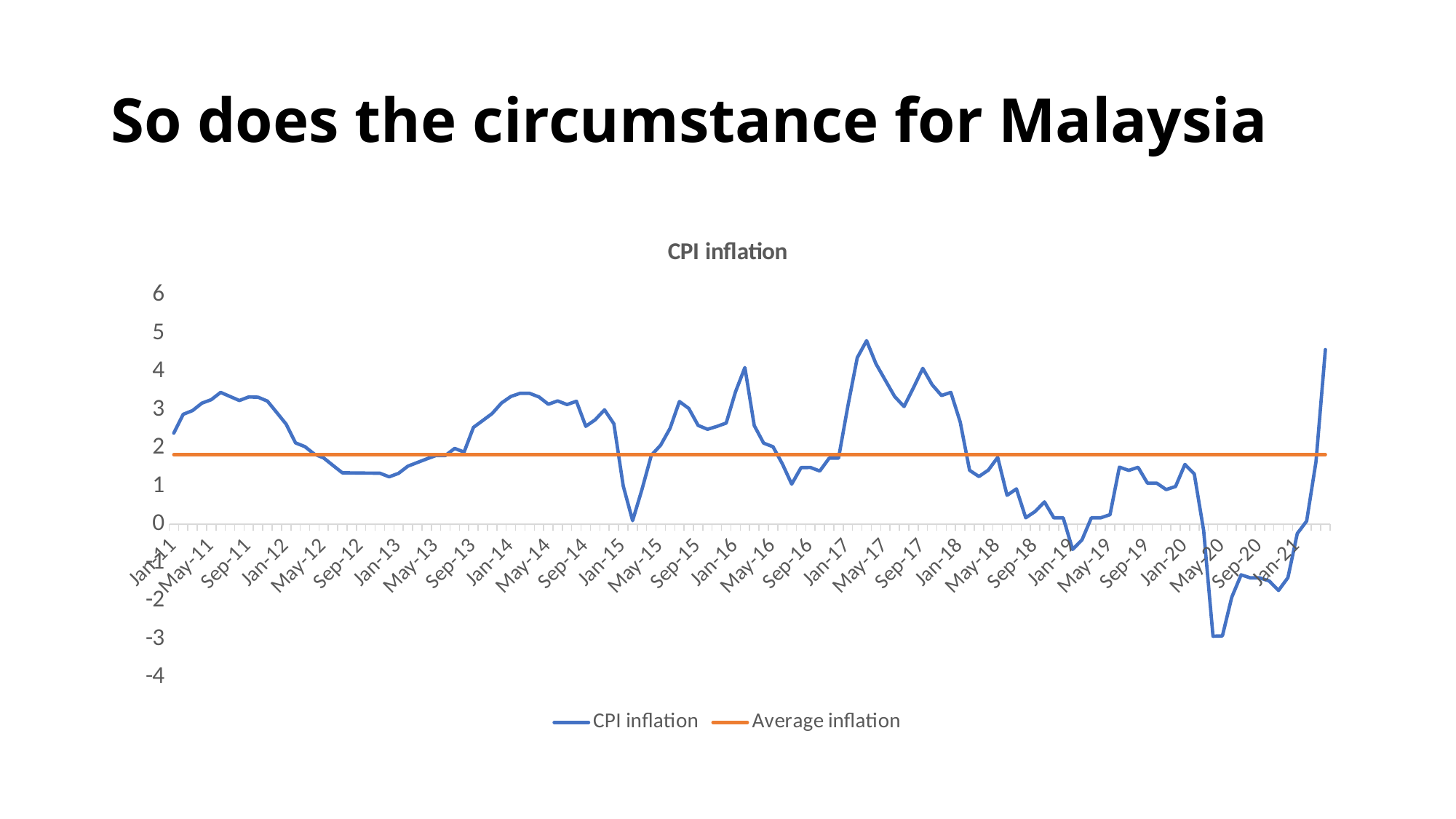
What is the title of the chart? CPI inflation Which series is drawn in orange according to the legend? Average inflation Around which labeled month does CPI inflation reach its lowest value? May-20 Which is larger, the CPI inflation value for Sep-11 or for Sep-12? Sep-11 Does CPI inflation rise or fall between Sep-11 and Sep-12? Fall Is the CPI inflation value for May-17 greater or less than 4? less Is the CPI inflation value for May-20 greater or less than -2? less Is the CPI inflation value for Sep-12 greater or less than 2? less How many series does the legend list? 2 What kind of chart is shown on the slide? Line chart